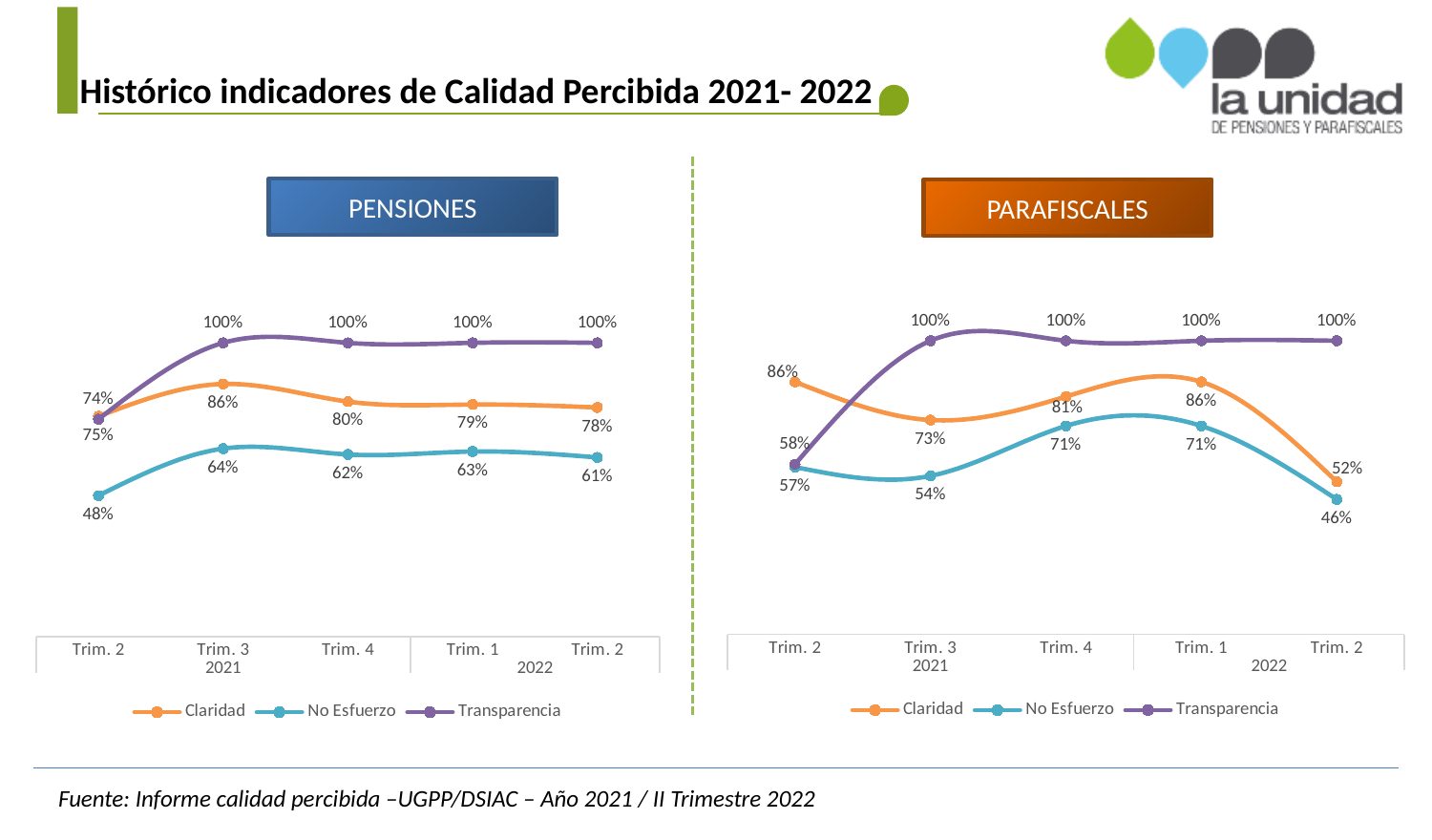
In the PARAFISCALES chart, what is the value of Claridad in Trim. 3 of 2021? 73% In the PENSIONES chart, what is the value of Claridad in Trim. 2 of 2022? 78% In the PENSIONES chart, what is the value of No Esfuerzo in Trim. 2 of 2021? 48% In the PENSIONES chart, which is larger in Trim. 4 of 2021: Claridad or No Esfuerzo? Claridad In the PENSIONES chart, what is the value of Claridad in Trim. 3 of 2021? 86% In the PARAFISCALES chart, what is the value of No Esfuerzo in Trim. 2 of 2022? 46% What type of chart is the PARAFISCALES chart? Line chart How many quarters are plotted on the x axis of the PENSIONES chart? 5 How many series does the legend of the PARAFISCALES chart list? 3 In the PARAFISCALES chart, in which quarter is Claridad lowest? Trim. 2 2022 In the PARAFISCALES chart, what is the difference between Claridad and No Esfuerzo in Trim. 1 of 2022? 15% In the PENSIONES chart, in which quarter is No Esfuerzo highest? Trim. 3 2021